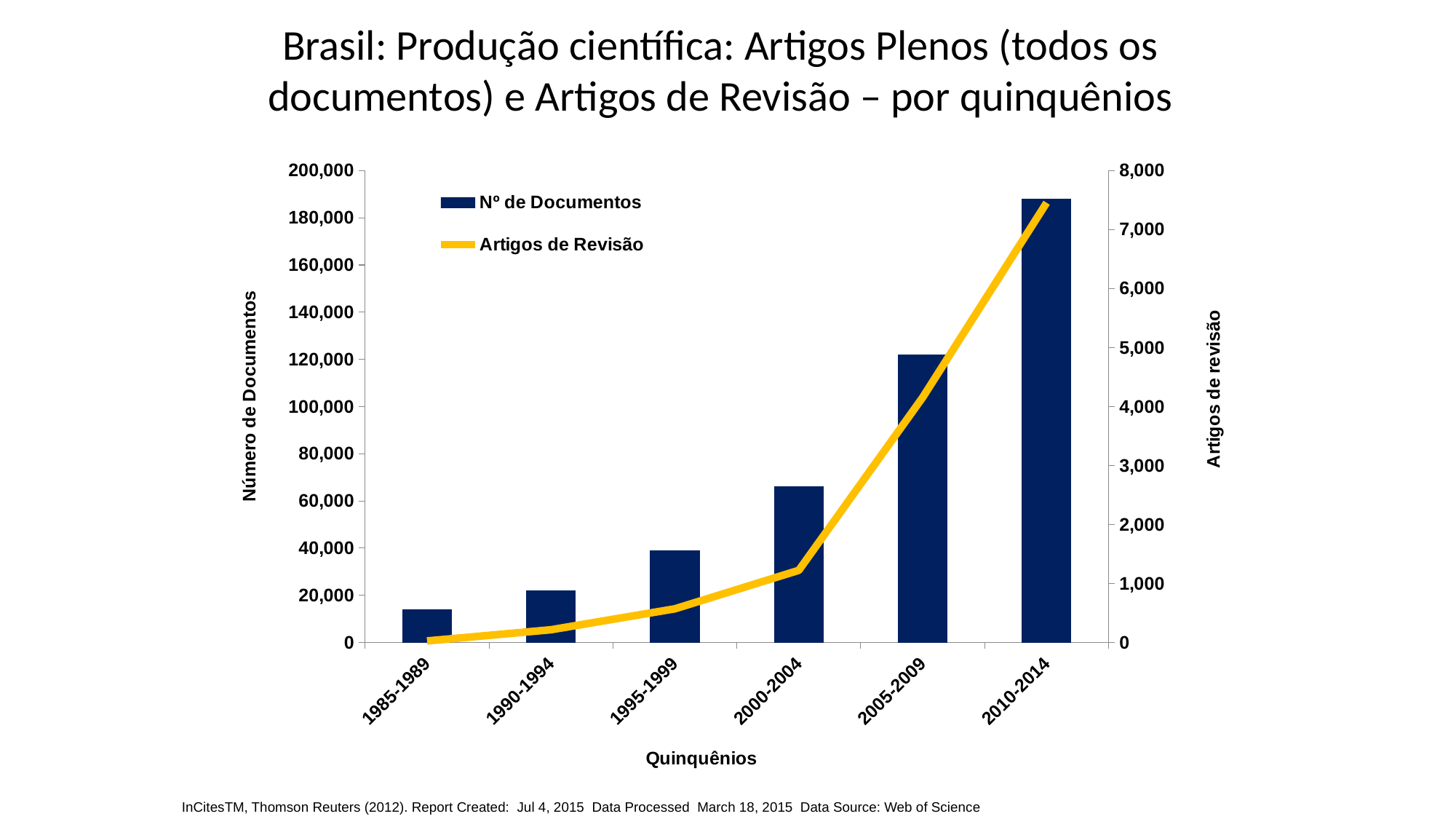
What kind of chart is shown on the slide? A combined bar and line chart Which period has the lowest Nº de Documentos? 1985-1989 Is the Nº de Documentos for 2010-2014 greater or less than 180,000? greater Is the Artigos de Revisão value for 2010-2014 greater or less than 7,000? greater Do the Artigos de Revisão values rise or fall from 1985-1989 to 2010-2014? rise Which period has the highest Nº de Documentos? 2010-2014 Is the Nº de Documentos for 2000-2004 greater or less than 60,000? greater How many series does the legend list? 2 Which period has more Nº de Documentos, 1995-1999 or 2005-2009? 2005-2009 How many quinquênios (periods) are shown on the x axis? 6